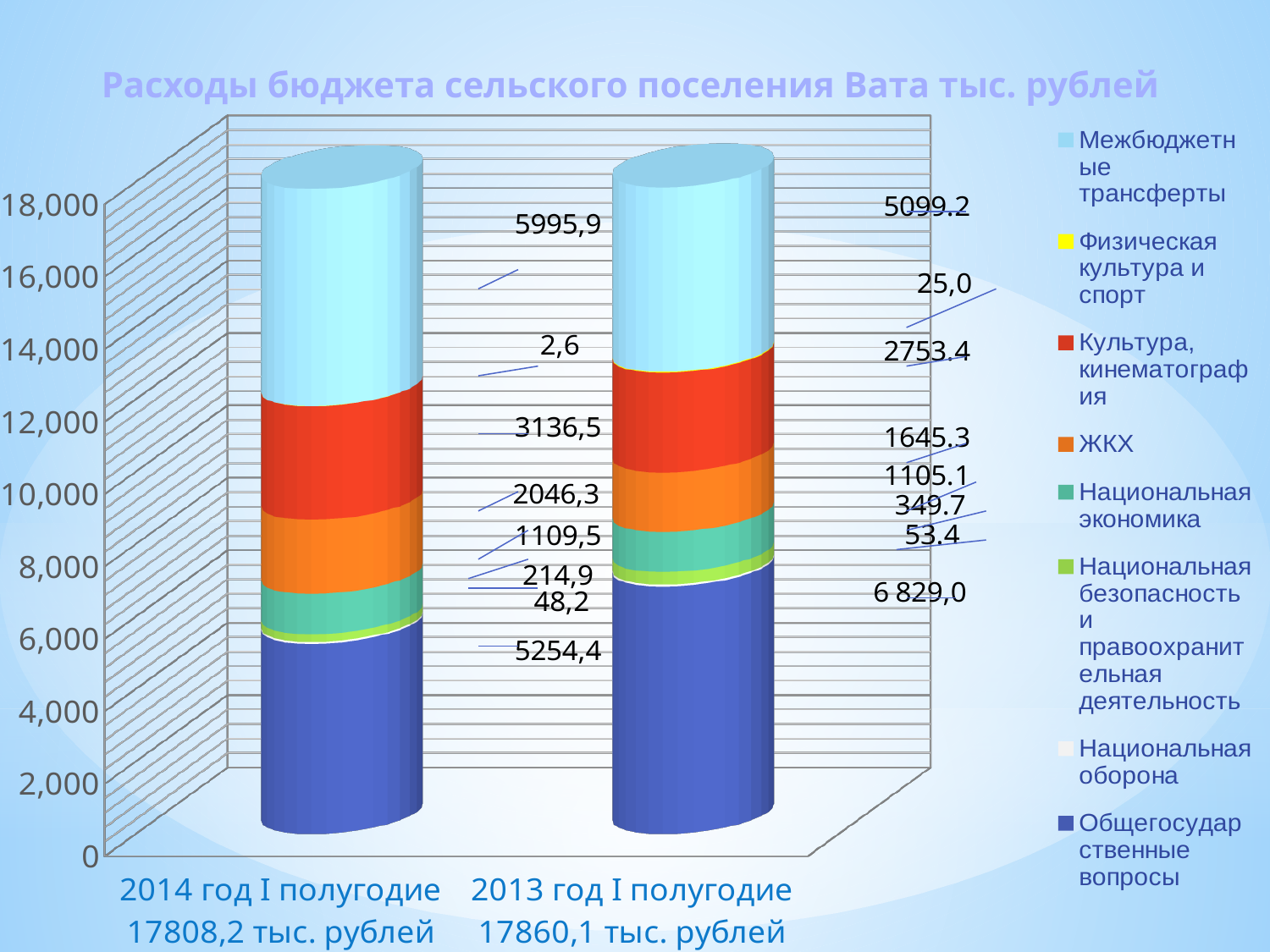
What is the value of Культура, кинематография for 2014 год I полугодие? 3136,5 What is the value of Общегосударственные вопросы for 2013 год I полугодие? 6 829,0 How many bars (categories) are plotted on the chart? 2 Which bar has the larger total, 2014 год I полугодие or 2013 год I полугодие? 2013 год I полугодие How many series does the legend list? 8 What is the total of the stacked bar for 2014 год I полугодие, as printed on the slide? 17808,2 тыс. рублей Which year has the larger value for Общегосударственные вопросы, 2014 год I полугодие or 2013 год I полугодие? 2013 год I полугодие What is the value of Межбюджетные трансферты for 2014 год I полугодие? 5995,9 Is the total height of the 2014 год I полугодие bar greater or less than 16,000? greater What kind of chart is shown on the slide? Stacked bar chart What is the difference between the Межбюджетные трансферты values for 2014 год I полугодие (5995,9) and 2013 год I полугодие (5099,2)? 896,7 What is the title of the chart? Расходы бюджета сельского поселения Вата тыс. рублей